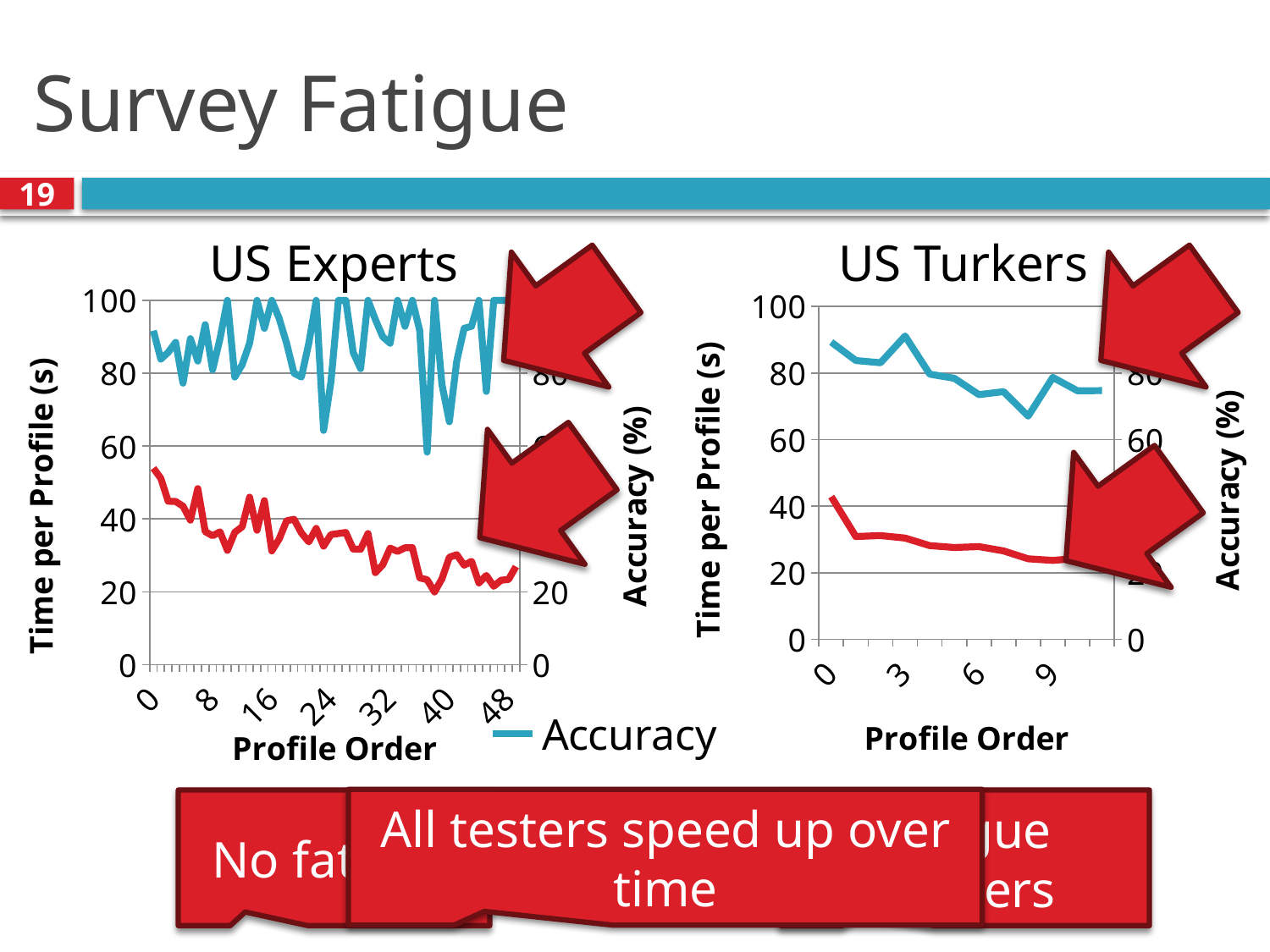
In the US Turkers chart, is the Time per Profile value at Profile Order 9 greater or less than 30? less In the US Turkers chart, is the Accuracy value at Profile Order 8 greater or less than 80? less In the US Experts chart, does the red Time per Profile line rise or fall as Profile Order increases? fall In the US Turkers chart, does the red Time per Profile line rise or fall as Profile Order increases? fall In the US Turkers chart, is the Accuracy value at Profile Order 3 greater or less than 80? greater What is the label of the horizontal axis on the US Experts chart? Profile Order What kind of chart is the US Turkers chart? line chart What is the label of the left vertical axis on the US Turkers chart? Time per Profile (s) What kind of chart is the US Experts chart? line chart In the US Turkers chart, does the blue Accuracy line rise or fall overall as Profile Order increases? fall